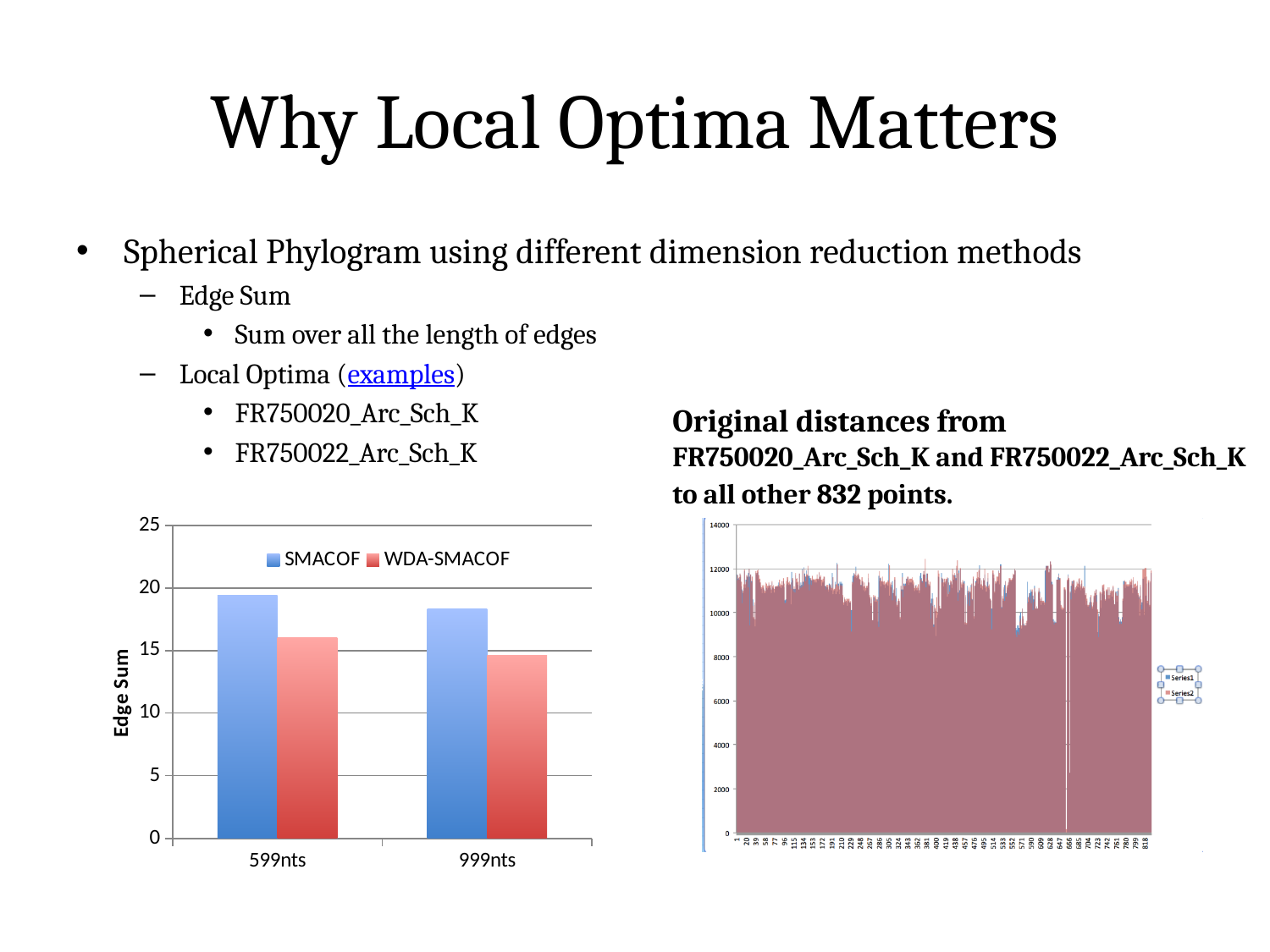
In the Edge Sum bar chart, which bar is the shortest overall? WDA-SMACOF at 999nts What are the two series named in the legend of the Edge Sum bar chart? SMACOF and WDA-SMACOF In the Edge Sum bar chart, which series has the larger value for 599nts, SMACOF or WDA-SMACOF? SMACOF In the Edge Sum bar chart, is the SMACOF value for 599nts greater or less than 15? greater How many categories are shown on the x axis of the Edge Sum bar chart? 2 How many series does the legend of the 'Original distances' chart on the right list? 2 In the Edge Sum bar chart, does the SMACOF value rise or fall from 599nts to 999nts? fall How many series does the legend of the Edge Sum bar chart list? 2 What kind of chart is the Edge Sum chart on the left of the slide? bar chart In the Edge Sum bar chart, which series has the larger value for 999nts, SMACOF or WDA-SMACOF? SMACOF In the Edge Sum bar chart, which bar is the tallest overall? SMACOF at 599nts In the Edge Sum bar chart, is the WDA-SMACOF value for 999nts greater or less than 10? greater